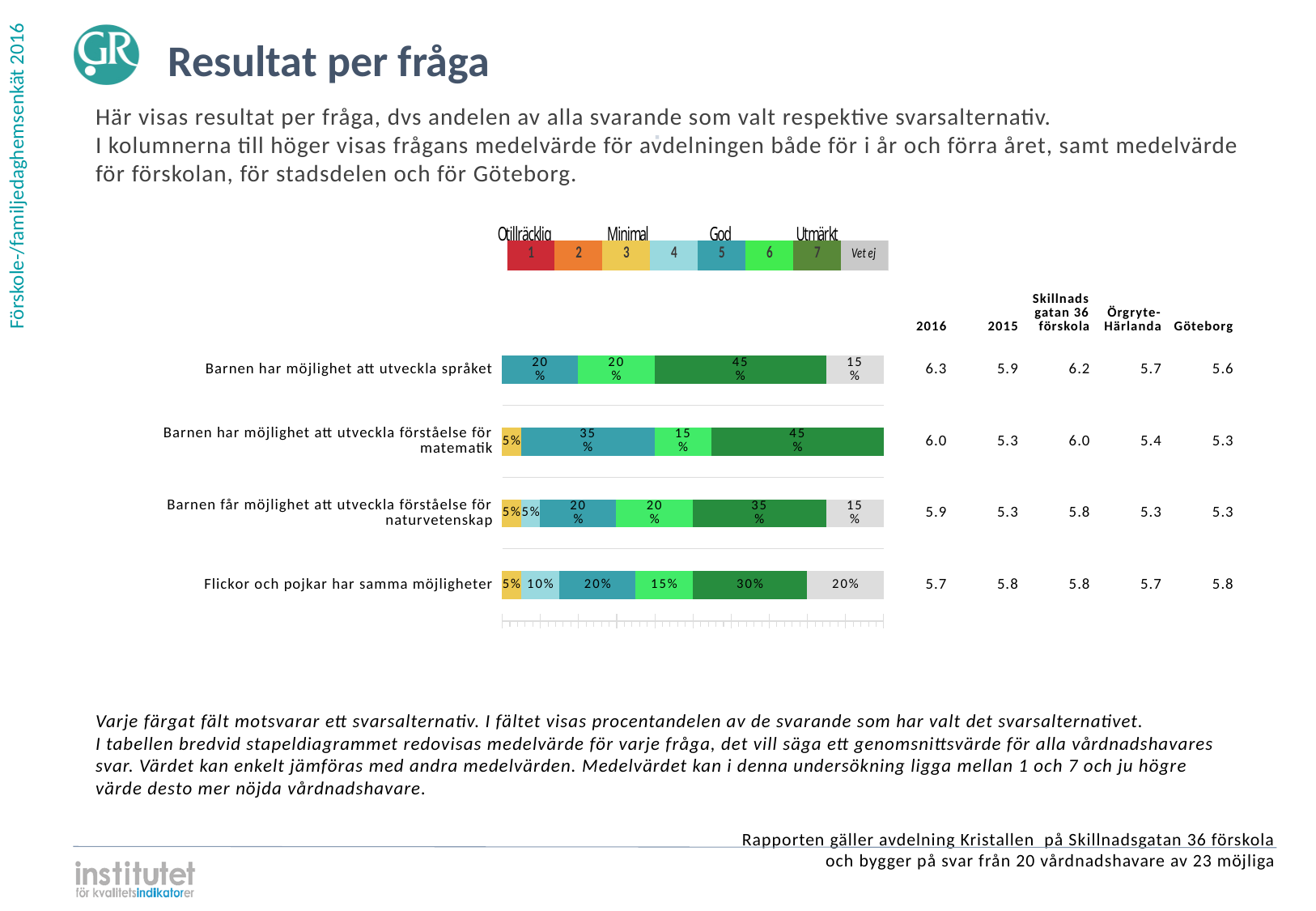
What kind of chart is shown on the slide? Stacked bar chart How many questions (categories) are plotted in the bar chart? 4 What percentage of respondents answered 'Vet ej' for 'Flickor och pojkar har samma möjligheter'? 20% Is the share choosing 5 larger for 'Barnen har möjlighet att utveckla förståelse för matematik' or for 'Flickor och pojkar har samma möjligheter'? Barnen har möjlighet att utveckla förståelse för matematik What is the 2016 mean value shown for 'Barnen har möjlighet att utveckla språket'? 6.3 Which question has the largest share of respondents choosing 7 (dark green)? Barnen har möjlighet att utveckla språket and Barnen har möjlighet att utveckla förståelse för matematik (both 45%) What percentage of respondents chose 7 (Utmärkt) for 'Barnen har möjlighet att utveckla språket'? 45% How many response options does the legend above the chart list? 8 What is the difference between the share choosing 7 for 'Barnen får möjlighet att utveckla förståelse för naturvetenskap' and for 'Flickor och pojkar har samma möjligheter'? 5% Which question has the smallest share of respondents choosing 7 (dark green)? Flickor och pojkar har samma möjligheter What colour represents response option 7 (Utmärkt) in the legend? Dark green What percentage of respondents chose 5 for 'Barnen har möjlighet att utveckla förståelse för matematik'? 35%